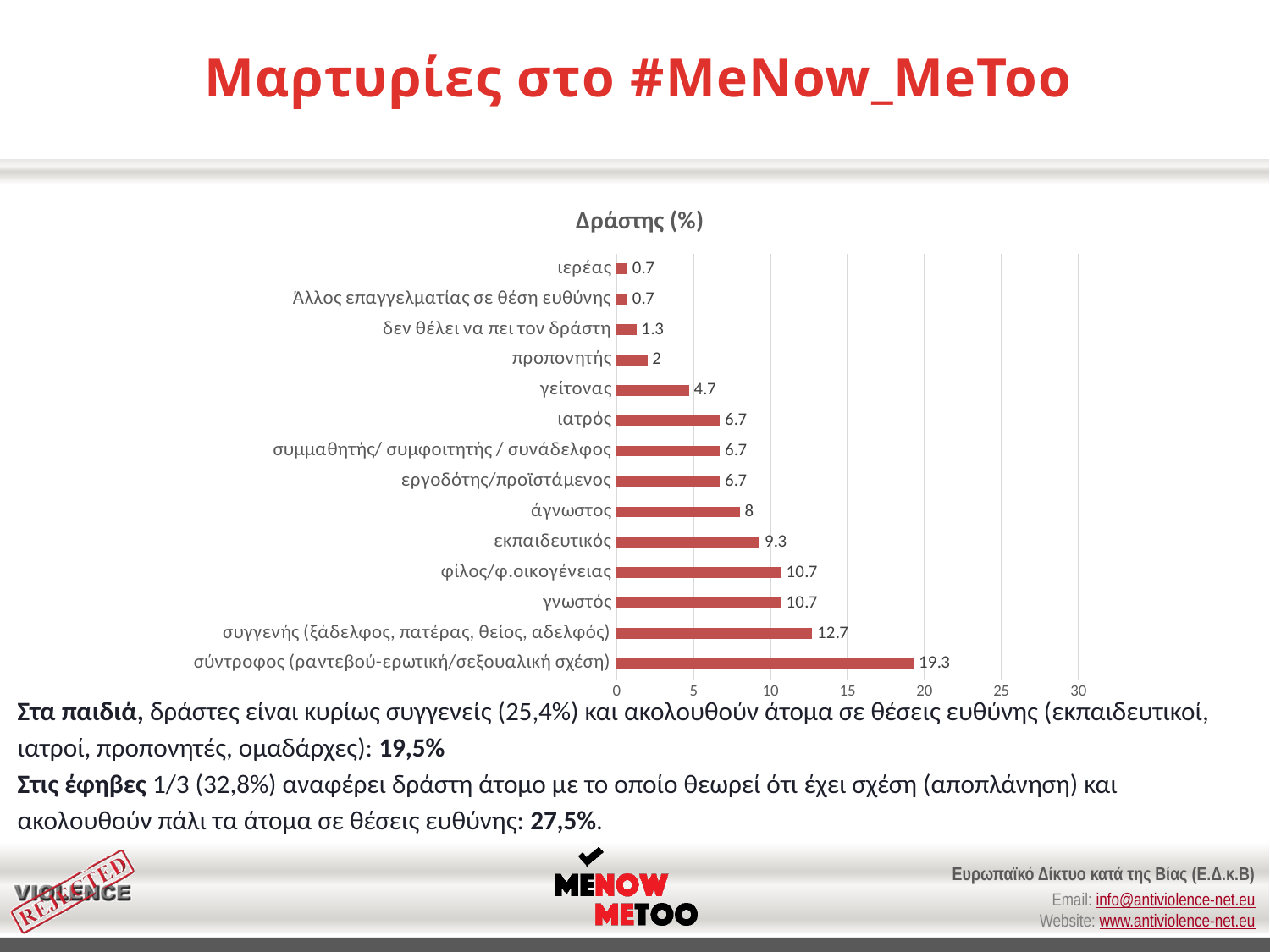
Which has a larger value, άγνωστος or γείτονας? άγνωστος What is the value for εκπαιδευτικός? 9.3 What is the title of the chart? Δράστης (%) What is the value for προπονητής? 2 What is the value for δεν θέλει να πει τον δράστη? 1.3 What is the value for γείτονας? 4.7 Which category has the highest value? σύντροφος (ραντεβού-ερωτική/σεξουαλική σχέση) What type of chart is shown on the slide? bar chart What is the difference between the values for σύντροφος (ραντεβού-ερωτική/σεξουαλική σχέση) and συγγενής (ξάδελφος, πατέρας, θείος, αδελφός)? 6.6 What is the value for σύντροφος (ραντεβού-ερωτική/σεξουαλική σχέση)? 19.3 How many categories are plotted in the chart? 14 Is the value for σύντροφος (ραντεβού-ερωτική/σεξουαλική σχέση) greater or less than 15? greater